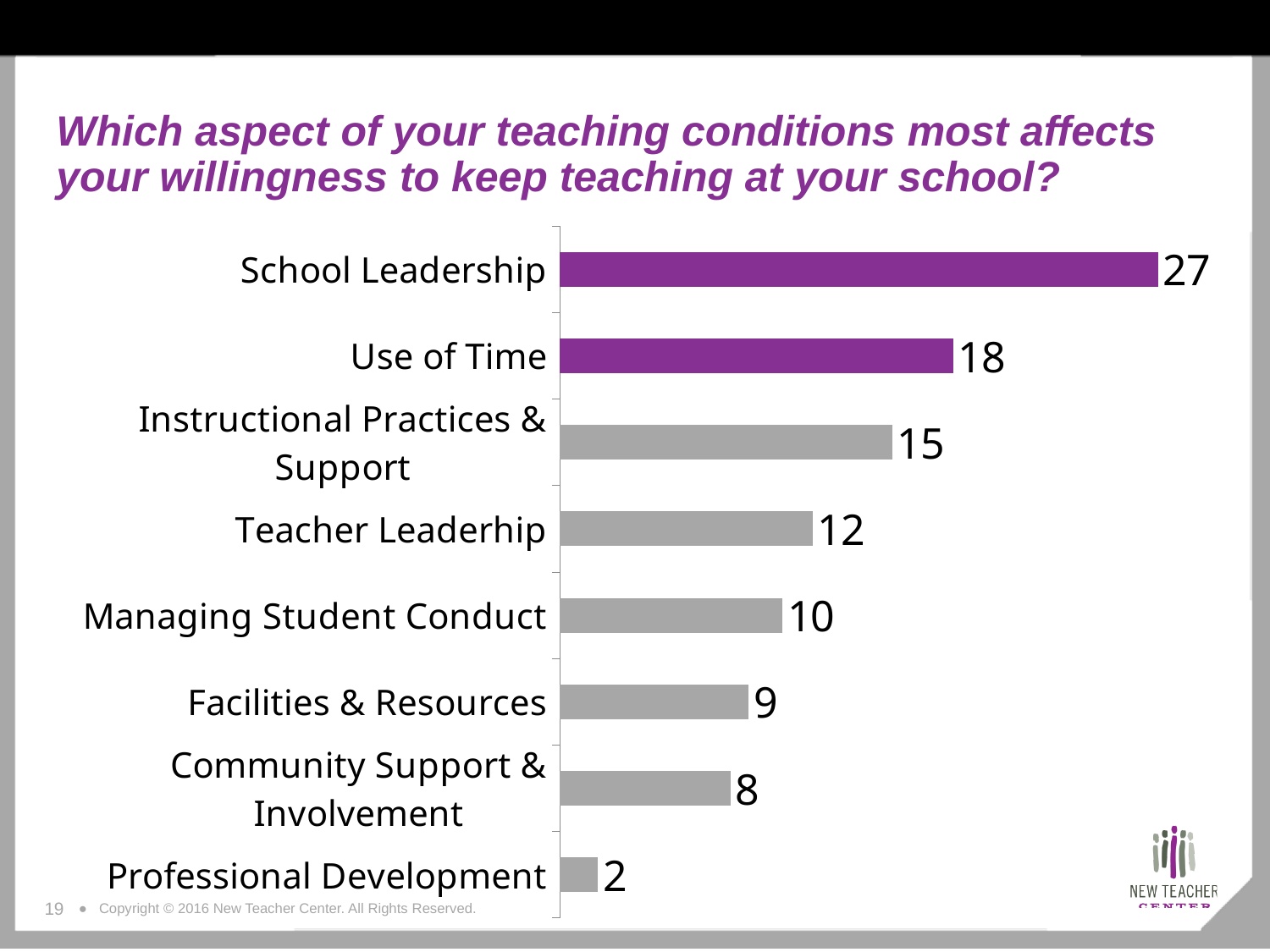
What is the value for School Leadership? 27 What kind of chart is shown on the slide? Bar chart Which category has the lowest value? Professional Development Which two bars are coloured purple rather than grey? School Leadership and Use of Time What is the value for Use of Time? 18 What is the value for Instructional Practices & Support? 15 What is the value for Professional Development? 2 Which is larger, the value for Managing Student Conduct or the value for Community Support & Involvement? Managing Student Conduct What is the difference between the values for School Leadership and Use of Time? 9 What is the difference between the values for Teacher Leaderhip and Facilities & Resources? 3 Which category has the highest value? School Leadership How many categories are shown in the chart? 8